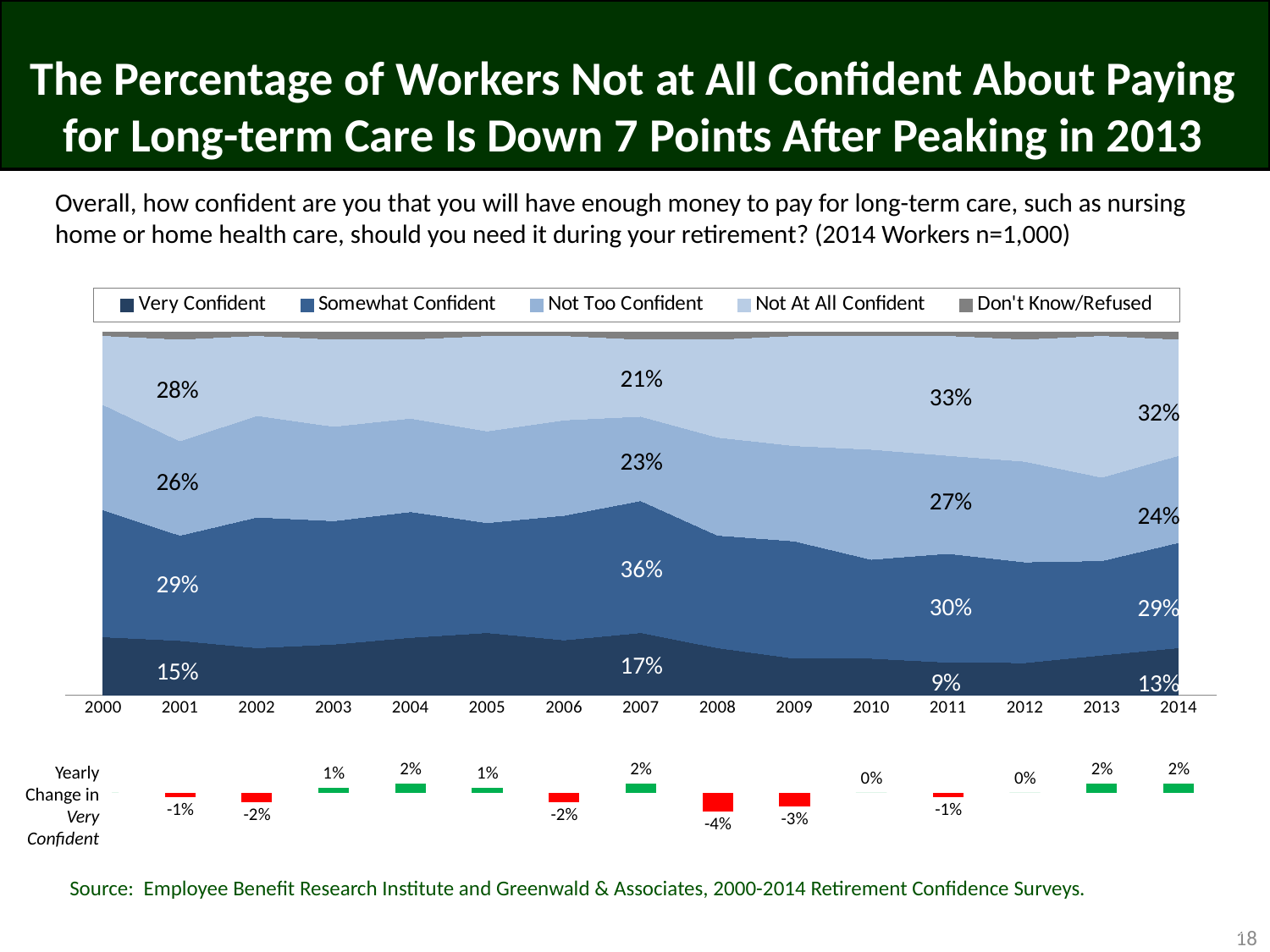
In the main stacked area chart, what percentage of workers were Somewhat Confident in 2007? 36% In the main stacked area chart, what is the difference between the Not At All Confident percentage in 2011 and in 2014? 1 percentage point In the lower chart of yearly change in Very Confident, what is the value for 2008? -4% In the main stacked area chart, how many years are shown on the x axis? 15 What kind of chart is the lower chart showing yearly change in Very Confident? Bar chart In the lower chart of yearly change in Very Confident, which year has the lowest value? 2008 In the main stacked area chart, what percentage of workers were Very Confident in 2011? 9% In the main stacked area chart, how many series does the legend list? 5 In the main stacked area chart, which is larger: the Very Confident percentage in 2007 or in 2011? 2007 In the lower chart of yearly change in Very Confident, what is the value for 2013? 2% In the main stacked area chart, what percentage of workers were Not At All Confident in 2014? 32% In the main stacked area chart, what percentage of workers were Not Too Confident in 2001? 26%